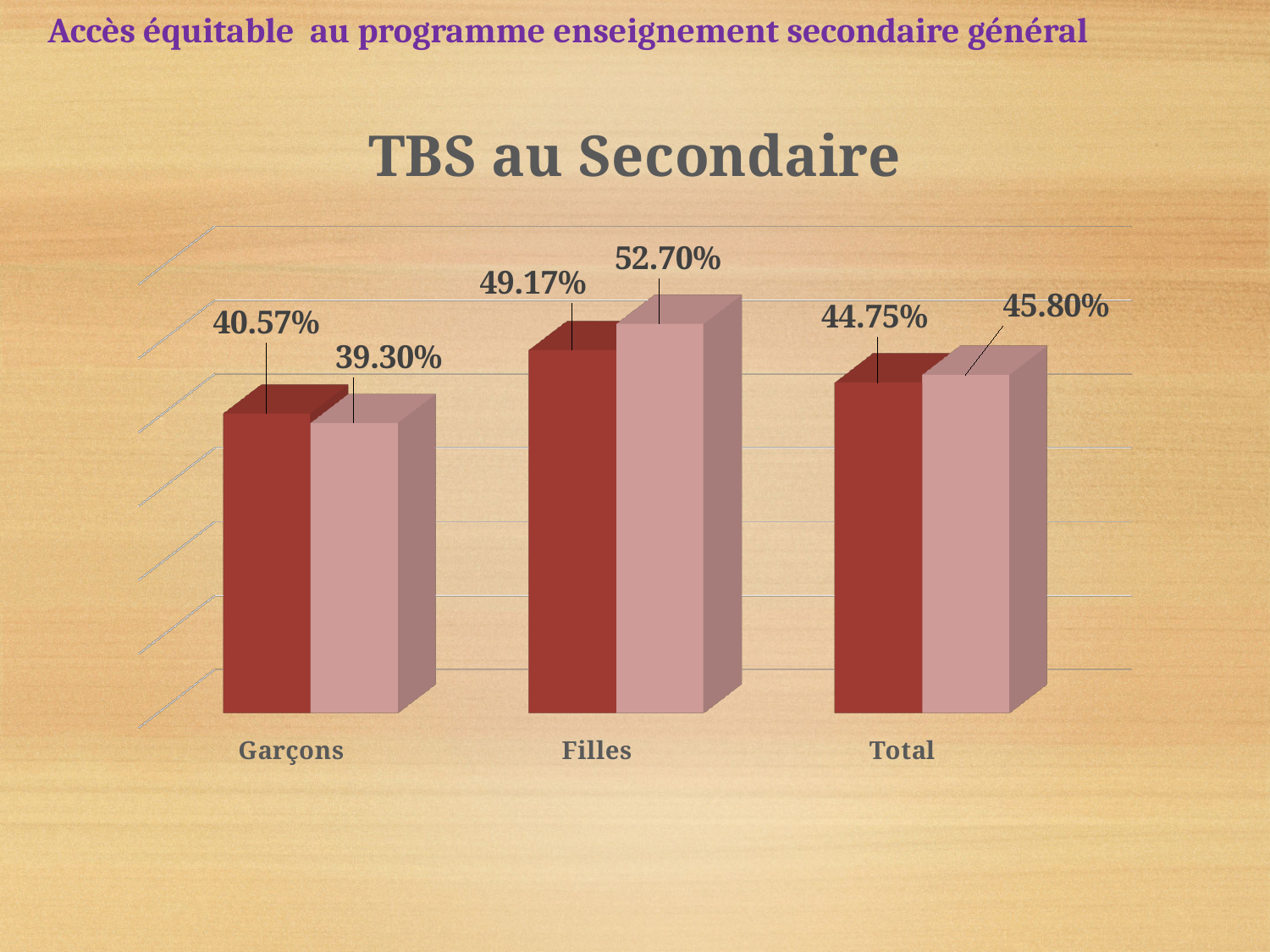
What is the value of the dark red bar for Total? 44.75% What is the value of the dark red bar for Garçons? 40.57% What is the difference between the dark red bars for Filles and Garçons? 8.60 percentage points For Filles, which bar is larger, the dark red bar or the pink bar? the pink bar What is the difference between the pink bar and the dark red bar for Filles? 3.53 percentage points What type of chart is shown on the slide? bar chart Which category has the lowest dark red bar? Garçons What is the title of the chart? TBS au Secondaire What is the value of the pink bar for Filles? 52.70% What is the value of the pink bar for Garçons? 39.30% Which category has the highest pink bar? Filles How many categories are shown on the x axis of the chart? 3